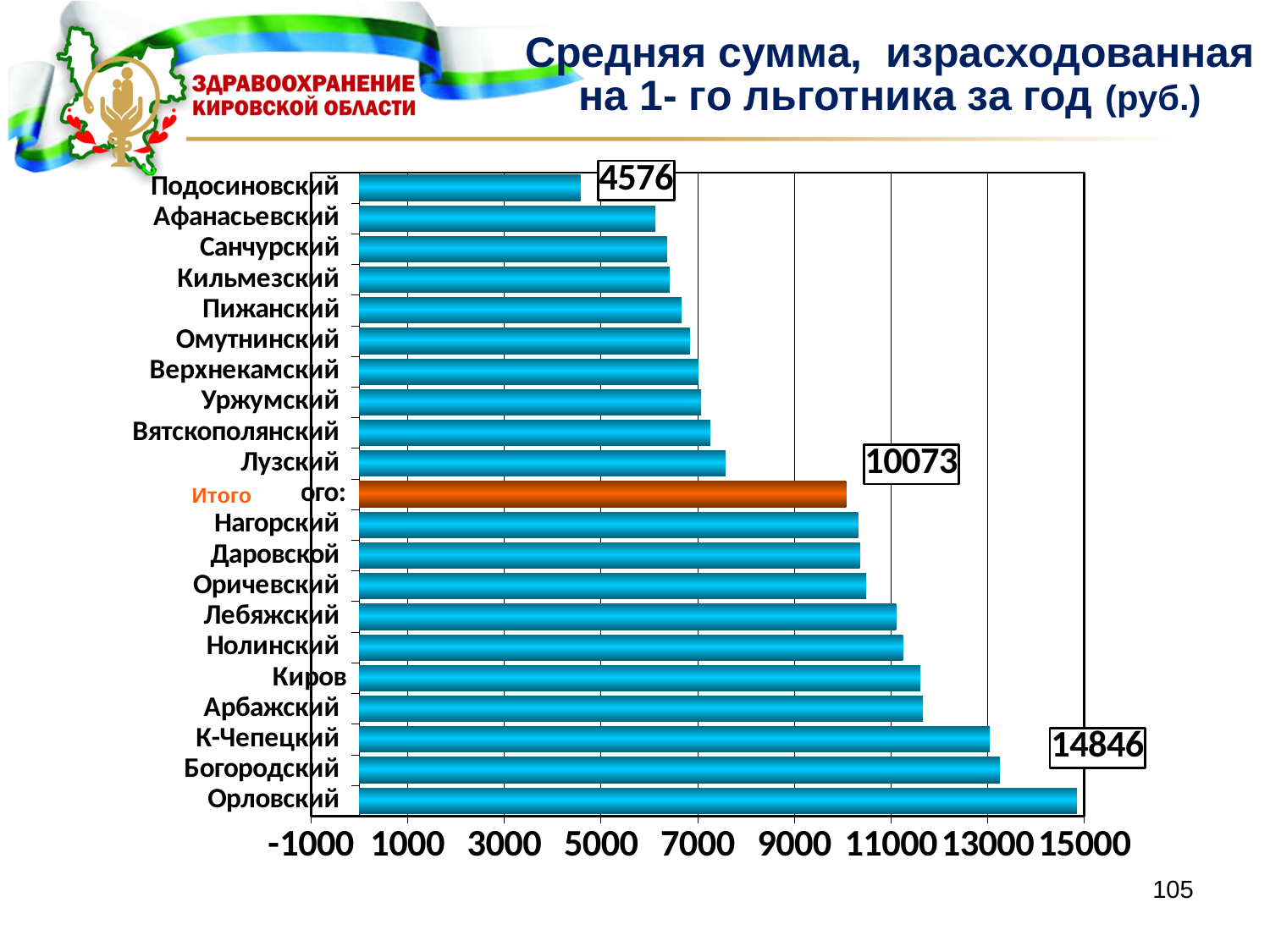
Which category has the highest value? Орловский Which category has the lowest value? Подосиновский What is the difference between the values for Орловский and Итого? 4773 Is the value for Киров greater or less than 11000? greater Which category's bar is shown in a different colour (orange) from the others? Итого What is the difference between the values for Орловский and Подосиновский? 10270 Which has a larger value, Киров or Лузский? Киров What is the value for Итого? 10073 What type of chart is shown on the slide? bar chart Is the value for Афанасьевский greater or less than 7000? less What is the value for Подосиновский? 4576 What is the value for Орловский? 14846